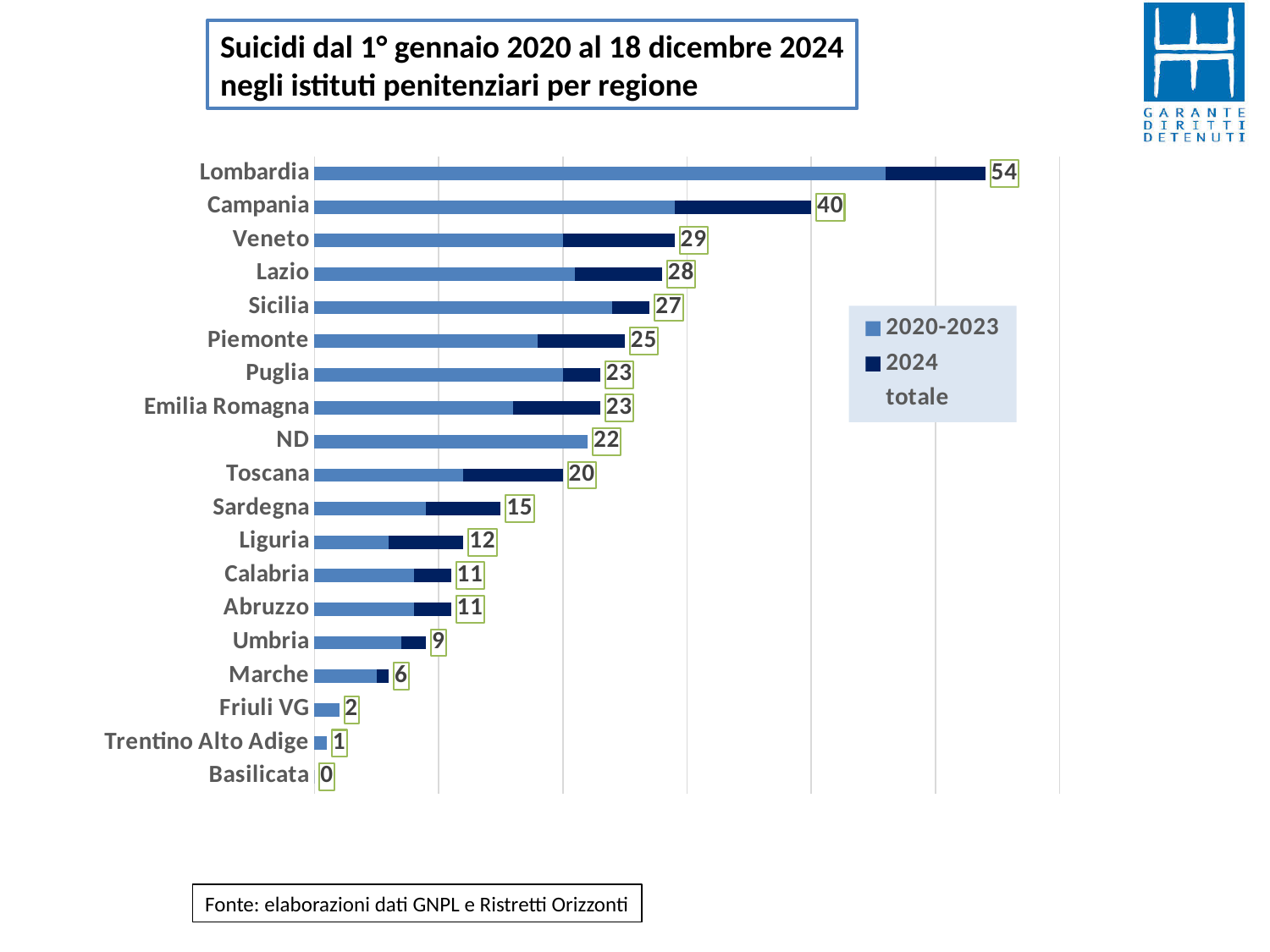
What is the total value shown for Campania? 40 What is the difference between the totals for Veneto and Liguria? 17 How many entries does the legend list? 3 Which has a larger total, Piemonte or Puglia? Piemonte What is the total value shown for Toscana? 20 How many regions (categories) are shown on the chart? 19 What kind of chart is shown on the slide? Stacked bar chart What is the total value shown for Sardegna? 15 Which region has the highest total? Lombardia Which region has the lowest total? Basilicata What is the total value shown for Lombardia? 54 What is the difference between the totals for Lombardia and Campania? 14